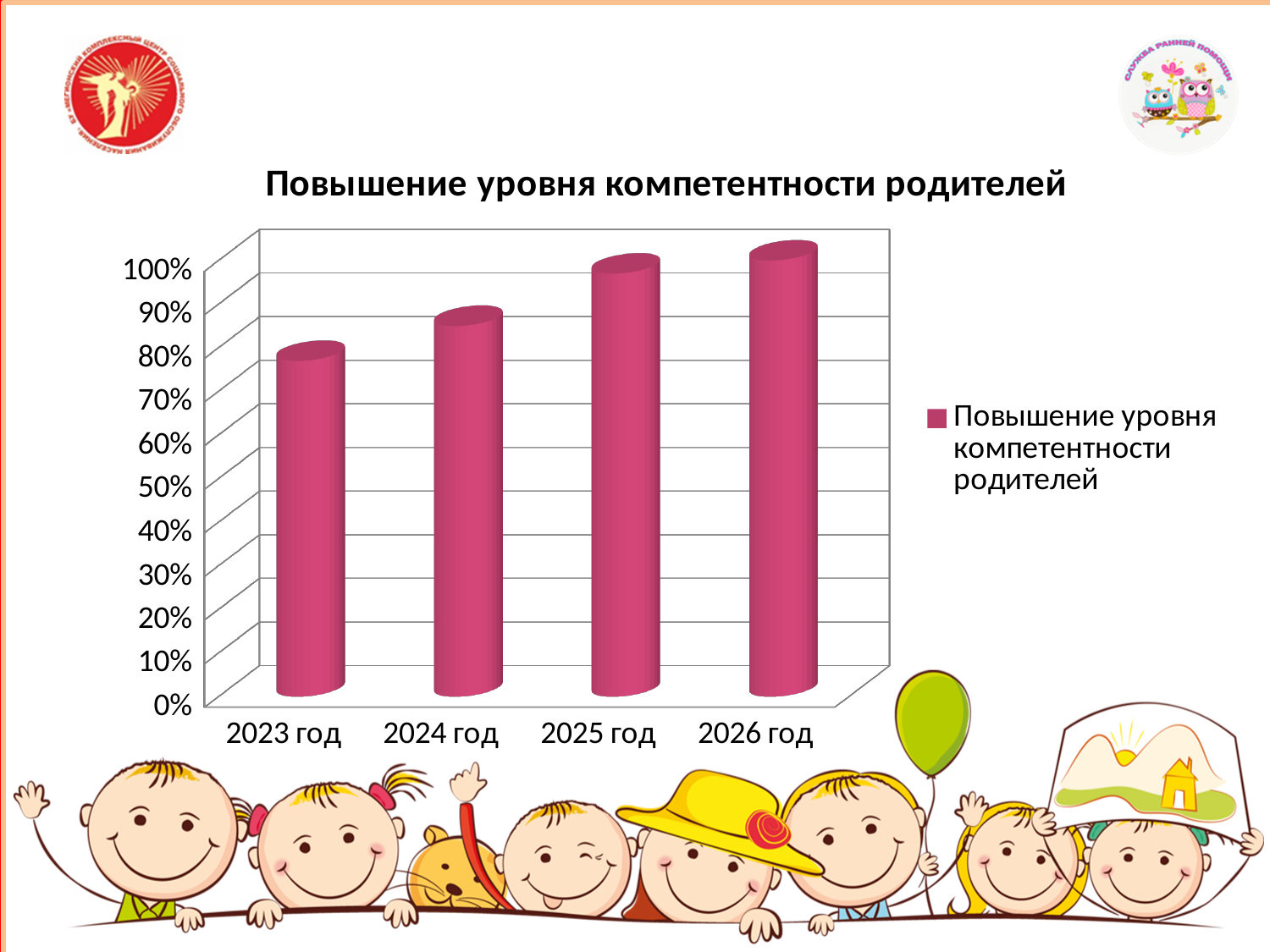
Is the value for 2025 год greater or less than 90%? greater Which year has the highest value in the chart? 2026 год How many categories (years) are shown on the x axis of the chart? 4 What kind of chart is shown on the slide? bar chart How many series does the chart legend list? 1 Is the value for 2024 год greater or less than 80%? greater Which year has the lowest value in the chart? 2023 год Which is larger, the value for 2023 год or the value for 2024 год? 2024 год Which is larger, the value for 2024 год or the value for 2025 год? 2025 год Do the values rise or fall from 2023 год to 2026 год? rise Is the value for 2023 год greater or less than 70%? greater What is the title of the chart? Повышение уровня компетентности родителей